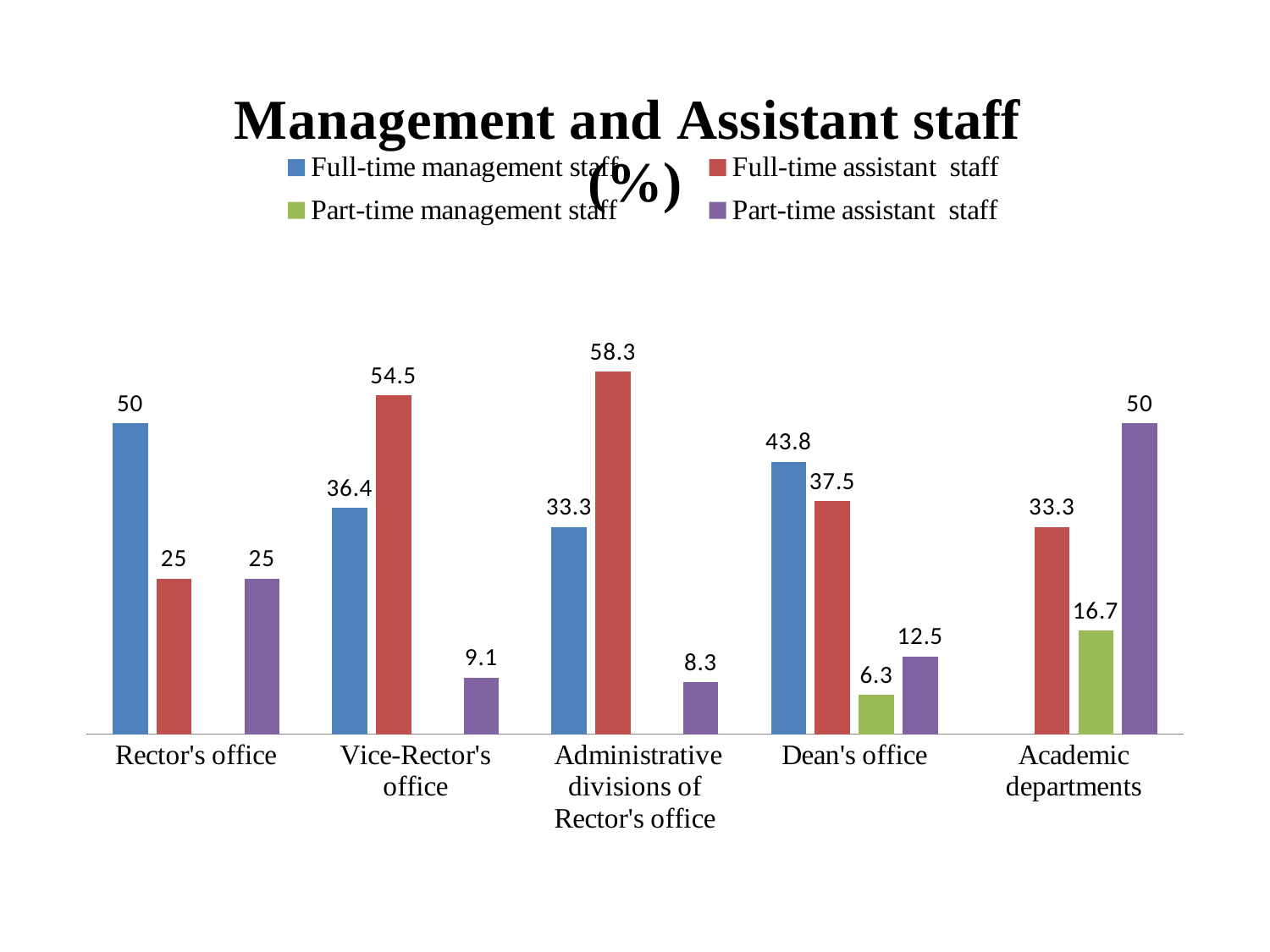
Which category has the lowest value for Part-time assistant staff? Administrative divisions of Rector's office How many categories are shown on the x axis? 5 What is the value for Part-time assistant staff in Academic departments? 50 How many series does the legend list? 4 What is the difference between Full-time assistant staff and Full-time management staff in the Vice-Rector's office? 18.1 What is the value for Full-time assistant staff in the Administrative divisions of Rector's office? 58.3 What is the value for Full-time management staff in the Dean's office? 43.8 In the Dean's office, which is larger: Full-time management staff or Full-time assistant staff? Full-time management staff Which colour represents Part-time management staff in the legend? Green What kind of chart is shown on the slide? Bar chart What is the value for Part-time management staff in the Dean's office? 6.3 Which category has the highest value for Full-time assistant staff? Administrative divisions of Rector's office